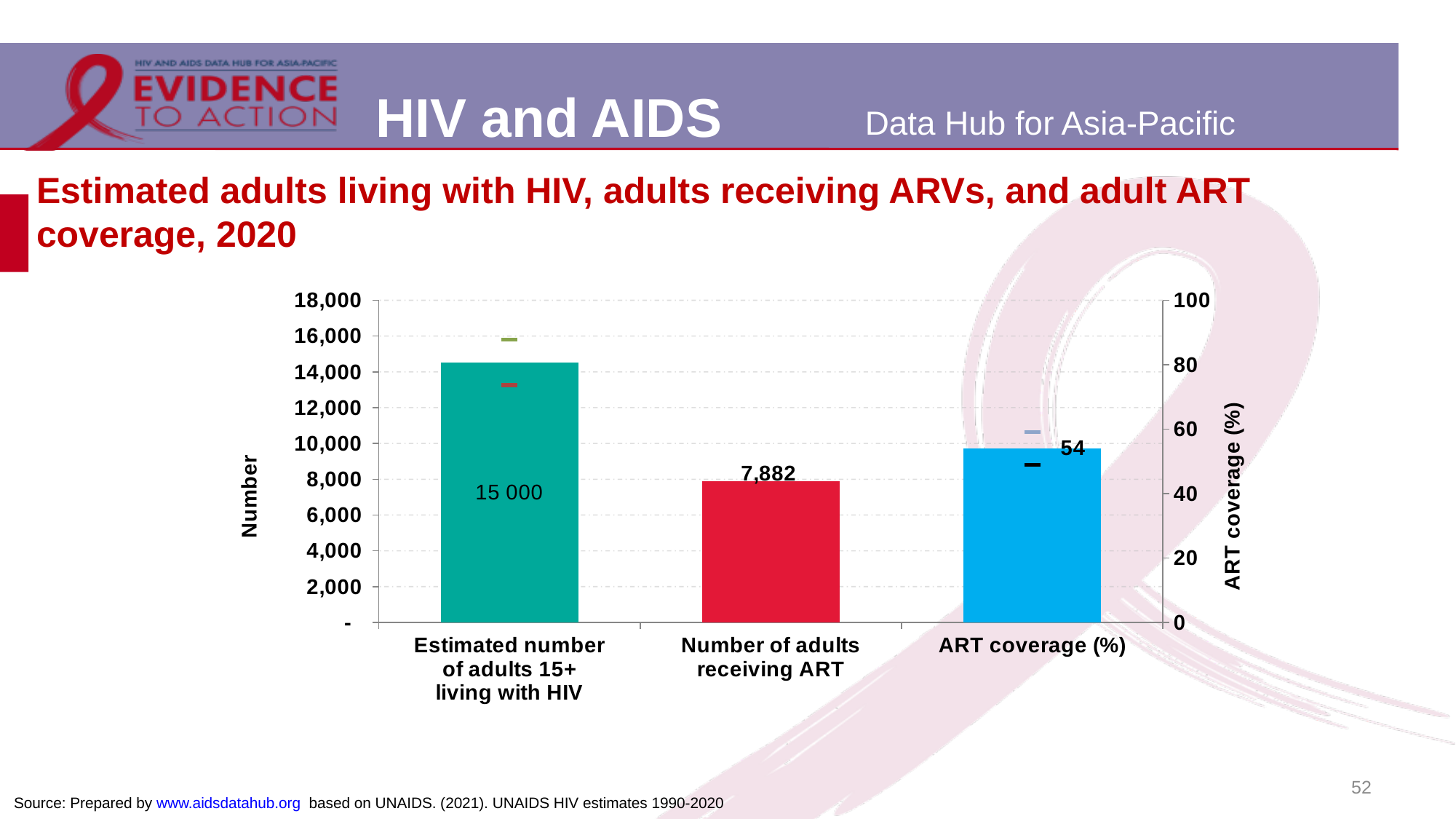
What is the estimated number of adults 15+ living with HIV shown on the chart? 15 000 How many bars are plotted on the chart? 3 What is the maximum value shown on the right vertical axis (ART coverage)? 100 What kind of chart is shown on the slide? Bar chart What is the ART coverage (%) value shown on the chart? 54 Is the ART coverage (%) value greater or less than 40? greater What is the number of adults receiving ART shown on the chart? 7,882 What is the difference between the estimated number of adults 15+ living with HIV (15 000) and the number of adults receiving ART (7,882)? 7,118 Which is larger: the estimated number of adults 15+ living with HIV or the number of adults receiving ART? Estimated number of adults 15+ living with HIV What is the title of the left vertical axis? Number Is the value for the number of adults receiving ART greater or less than 10,000? less